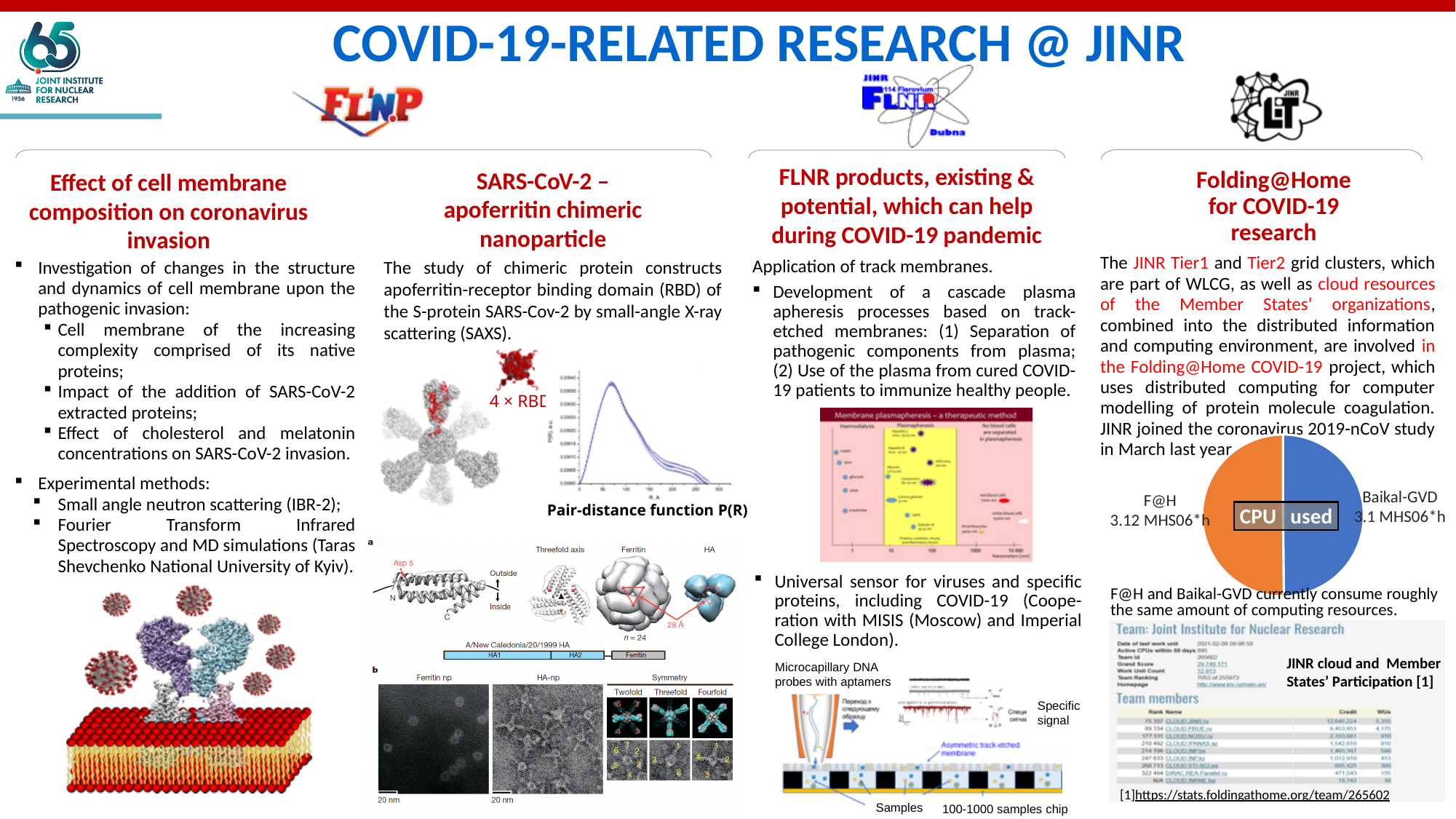
What kind of chart is the "CPU used" chart on the right of the slide? pie chart In the "CPU used" pie chart, what colour is the F@H slice? orange In the "CPU used" pie chart, what is the value for Baikal-GVD? 3.1 MHS06*h What is the title shown in the centre of the pie chart on the right of the slide? CPU used In the "CPU used" pie chart, what is the value for F@H? 3.12 MHS06*h In the "CPU used" pie chart, which has the larger value according to the printed labels, F@H or Baikal-GVD? F@H How many slices does the "CPU used" pie chart have? 2 What kind of chart is the "Pair-distance function P(R)" chart in the second column? line chart In the "CPU used" pie chart, what is the difference between the F@H and Baikal-GVD values? 0.02 MHS06*h In the "CPU used" pie chart, which slice has the highest printed value? F@H